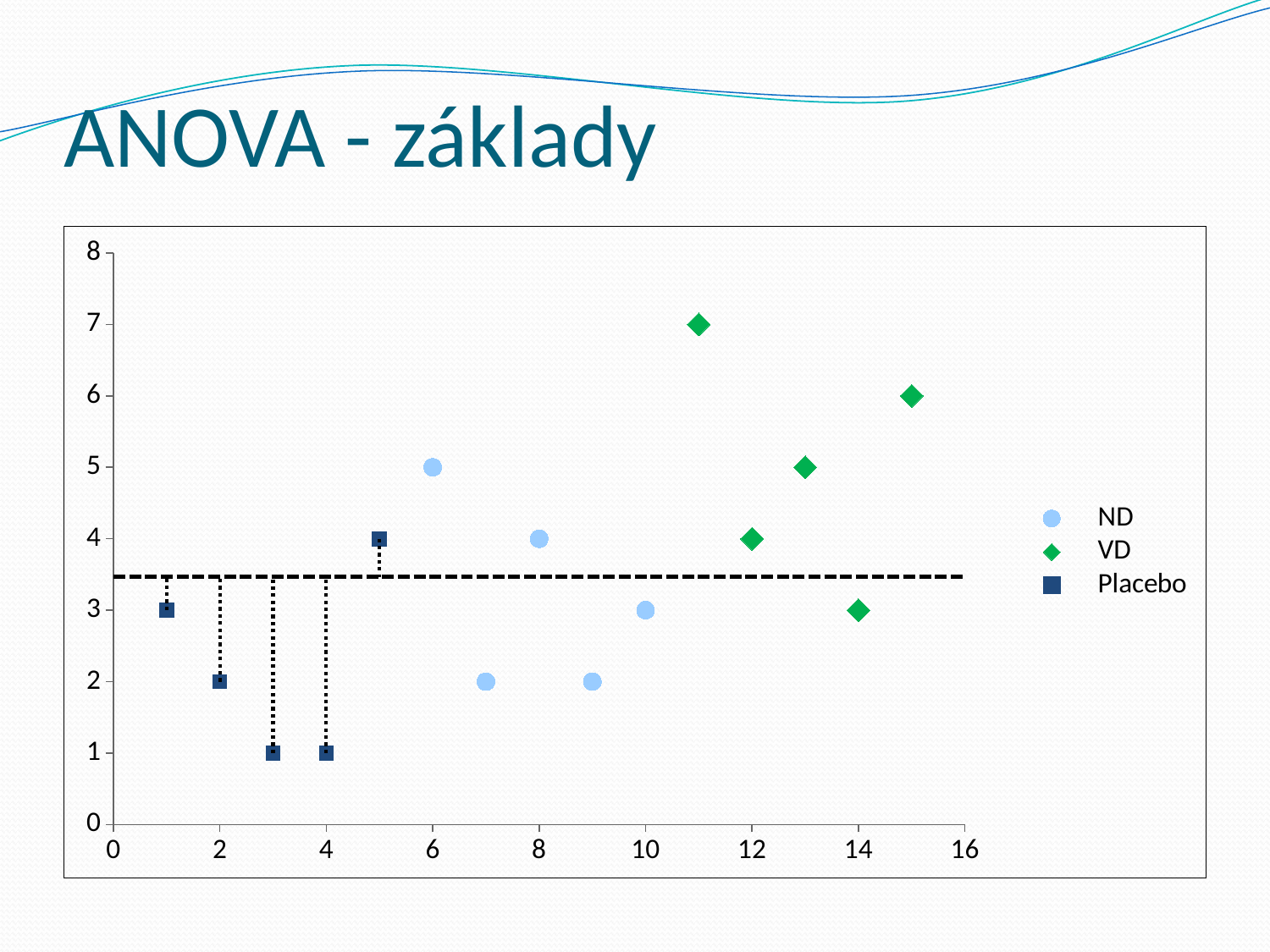
How many series does the legend list? 3 Which series is shown with green diamond markers? VD What is the difference between the y value of the VD point at x = 15 and the ND point at x = 10? 3 What is the y value of the VD point at x = 11? 7 Which series contains the point with the highest y value? VD Which has the larger y value: the Placebo point at x = 1 or the ND point at x = 7? Placebo point at x = 1 What is the lowest y value plotted on the chart? 1 What kind of chart is shown on the slide? scatter chart How many Placebo points are plotted? 5 What is the y value of the ND point at x = 6? 5 What is the y value of the Placebo point at x = 5? 4 How many VD points are plotted? 5